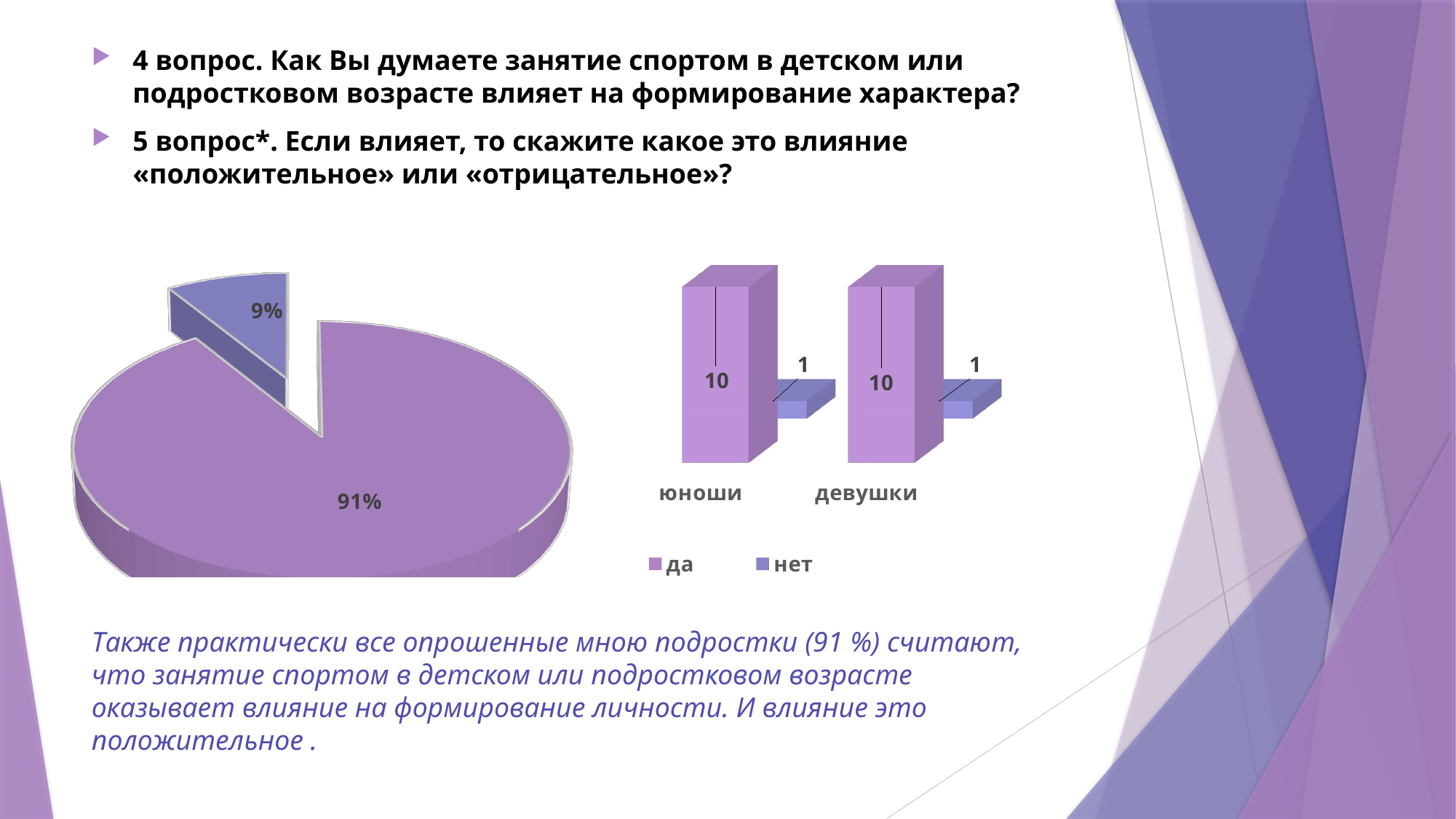
How many series does the legend of the bar chart on the right list? 2 How many categories are shown on the x axis of the bar chart on the right? 2 In the bar chart on the right, what is the difference between "да" and "нет" for "юноши"? 9 How many slices does the pie chart on the left have? 2 In the pie chart on the left, what percentage is shown on the largest slice? 91% In the bar chart on the right, which is larger for "девушки": "да" or "нет"? да In the bar chart on the right, what is the value of "нет" for "девушки"? 1 In the pie chart on the left, what is the difference in percentage points between the larger and the smaller slice? 82 In the bar chart on the right, what is the value of "да" for "юноши"? 10 In the pie chart on the left, what percentage is shown on the smallest slice? 9% What kind of chart is the chart on the left of the slide? pie chart What kind of chart is the chart on the right of the slide? bar chart